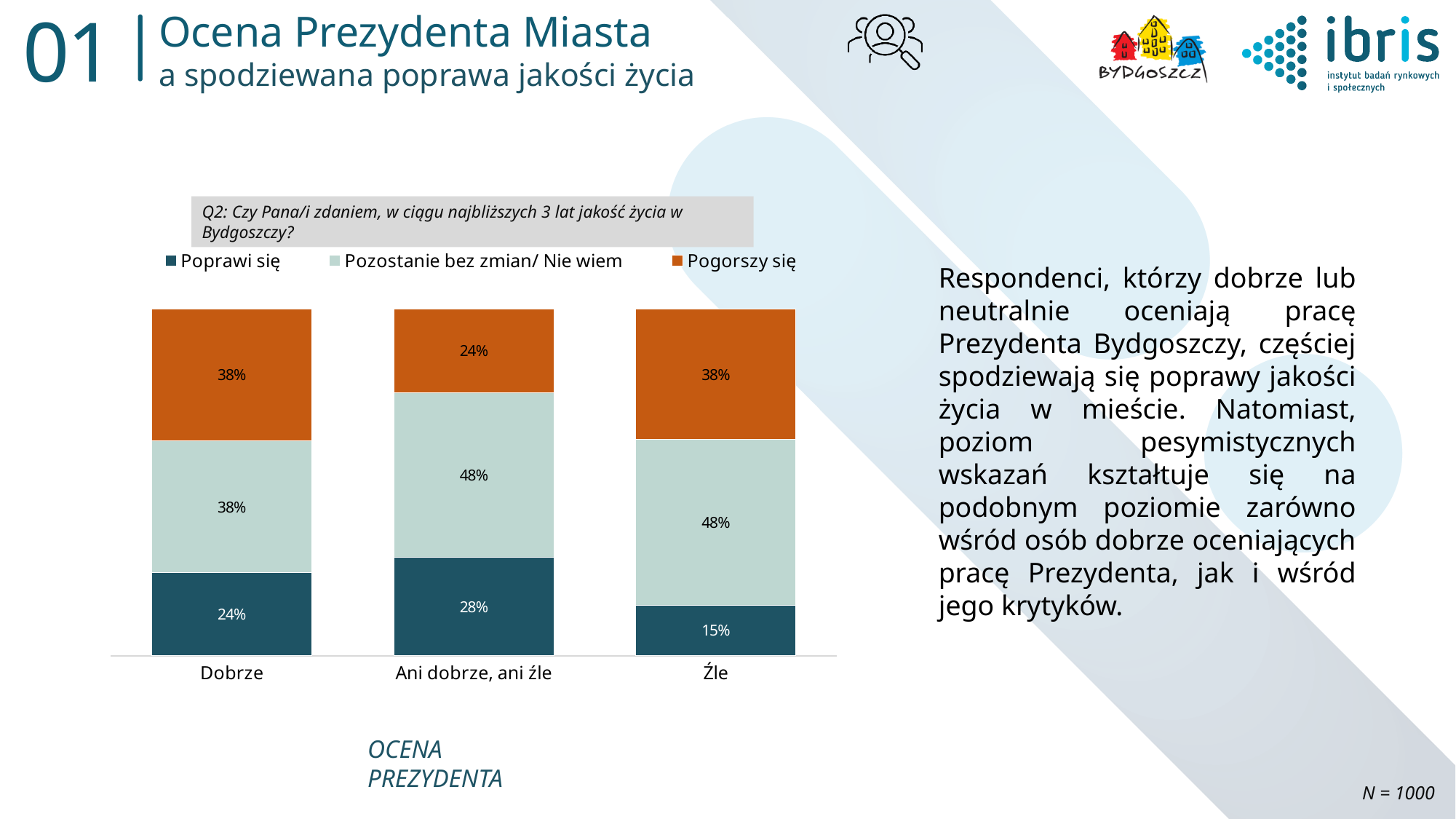
Which category has the lowest 'Poprawi się' value? Źle Which category has the highest 'Poprawi się' value? Ani dobrze, ani źle Is the 'Pozostanie bez zmian/ Nie wiem' value larger for 'Dobrze' or for 'Ani dobrze, ani źle'? Ani dobrze, ani źle What is the 'Pozostanie bez zmian/ Nie wiem' value for the 'Źle' category? 48% What kind of chart is shown on the slide? Stacked bar chart What percentage of respondents who rate the President 'Dobrze' answered 'Poprawi się'? 24% What is the difference between the 'Poprawi się' values for 'Ani dobrze, ani źle' and 'Źle'? 13 percentage points What is the 'Pogorszy się' value for the 'Ani dobrze, ani źle' category? 24% What is the 'Poprawi się' value for the 'Źle' category? 15% Which category has the lowest 'Pogorszy się' value? Ani dobrze, ani źle How many series does the chart legend list? 3 How many categories are shown on the x axis of the chart? 3